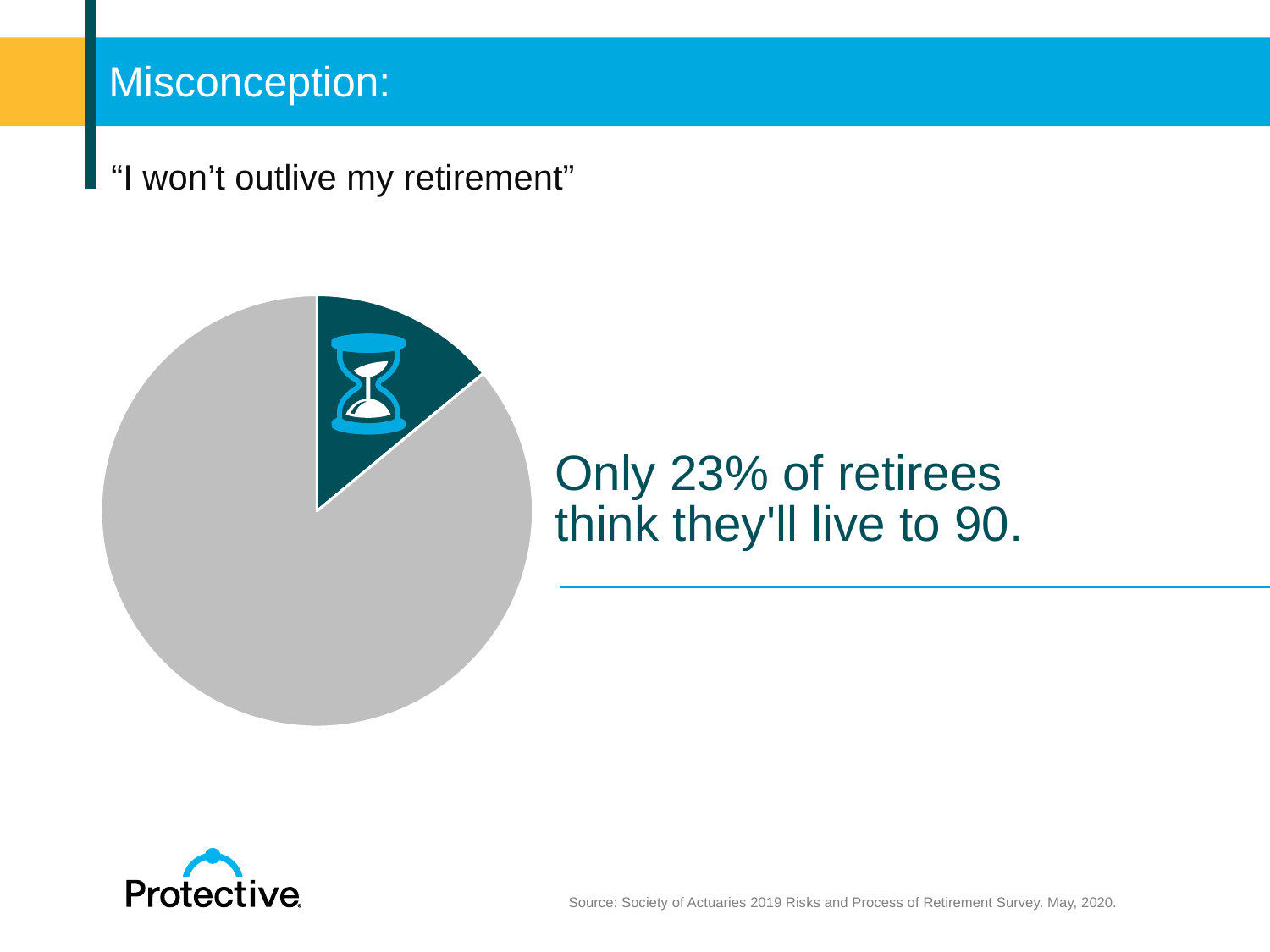
Which slice of the pie chart is the smallest? dark teal slice How many slices does the pie chart have? 2 Which slice of the pie chart is the largest? gray slice Which slice of the pie chart is larger, the gray slice or the dark teal slice? gray slice What icon is shown inside the dark teal slice of the pie chart? an hourglass What kind of chart is shown on the slide? pie chart What percentage of retirees think they'll live to 90, according to the slide? 23% What colour is the slice representing the 23% of retirees who think they'll live to 90? dark teal